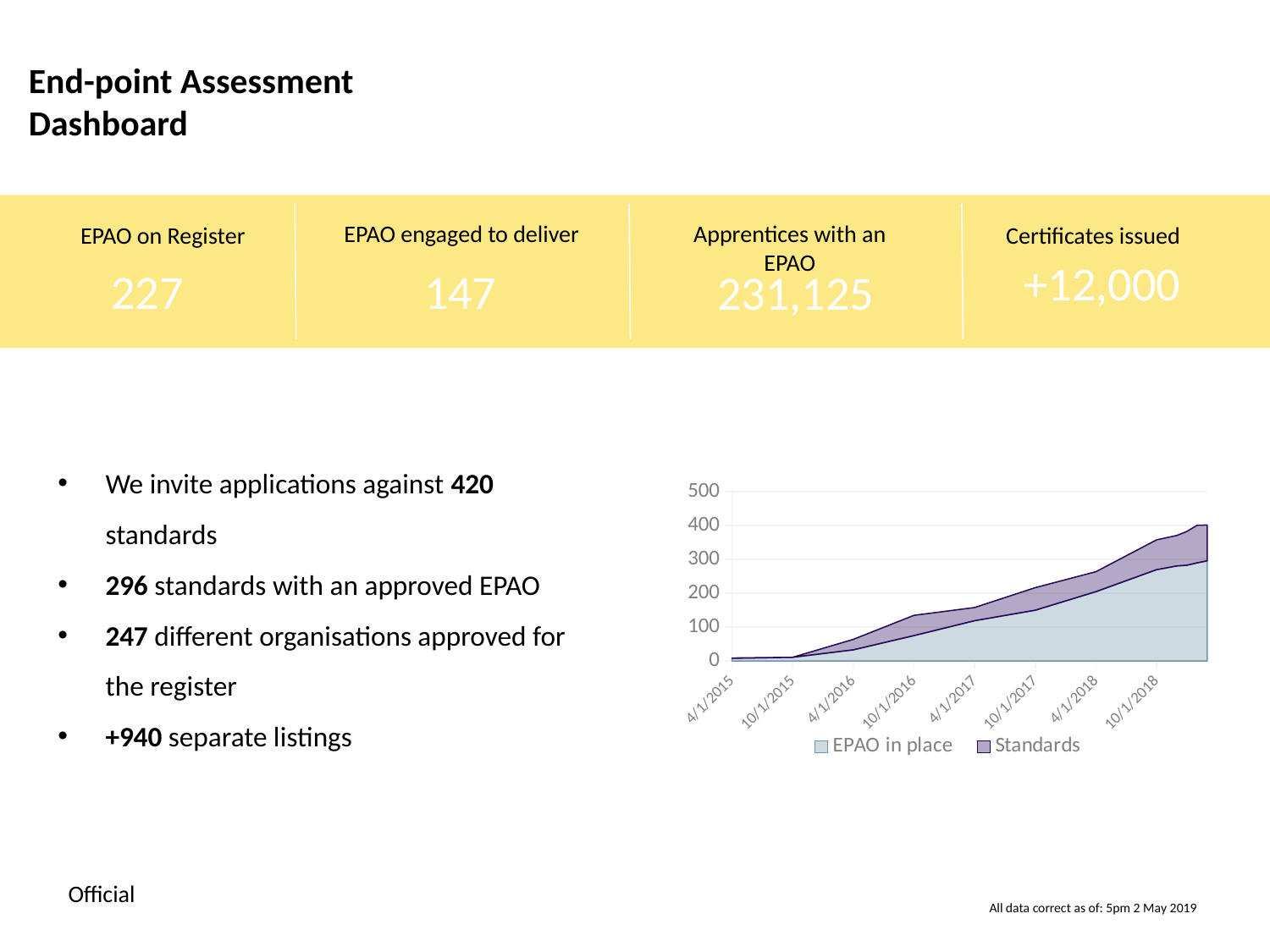
Which series reaches the highest value anywhere on the chart? EPAO in place Is the value for Standards at 4/1/2016 greater or less than 100? less Is the value for EPAO in place at the right-hand end of the chart greater or less than 200? greater How many date labels are shown on the chart's x axis? 8 At the right-hand end of the chart, which series is higher: Standards or EPAO in place? EPAO in place Is the value for Standards at the right-hand end of the chart greater or less than 300? less What is the highest value shown on the chart's y axis? 500 How many series does the chart's legend list? 2 What are the two series named in the chart legend? EPAO in place and Standards Do the values in the chart rise or fall from 4/1/2015 to 10/1/2018? rise What kind of chart is shown on the slide? area chart